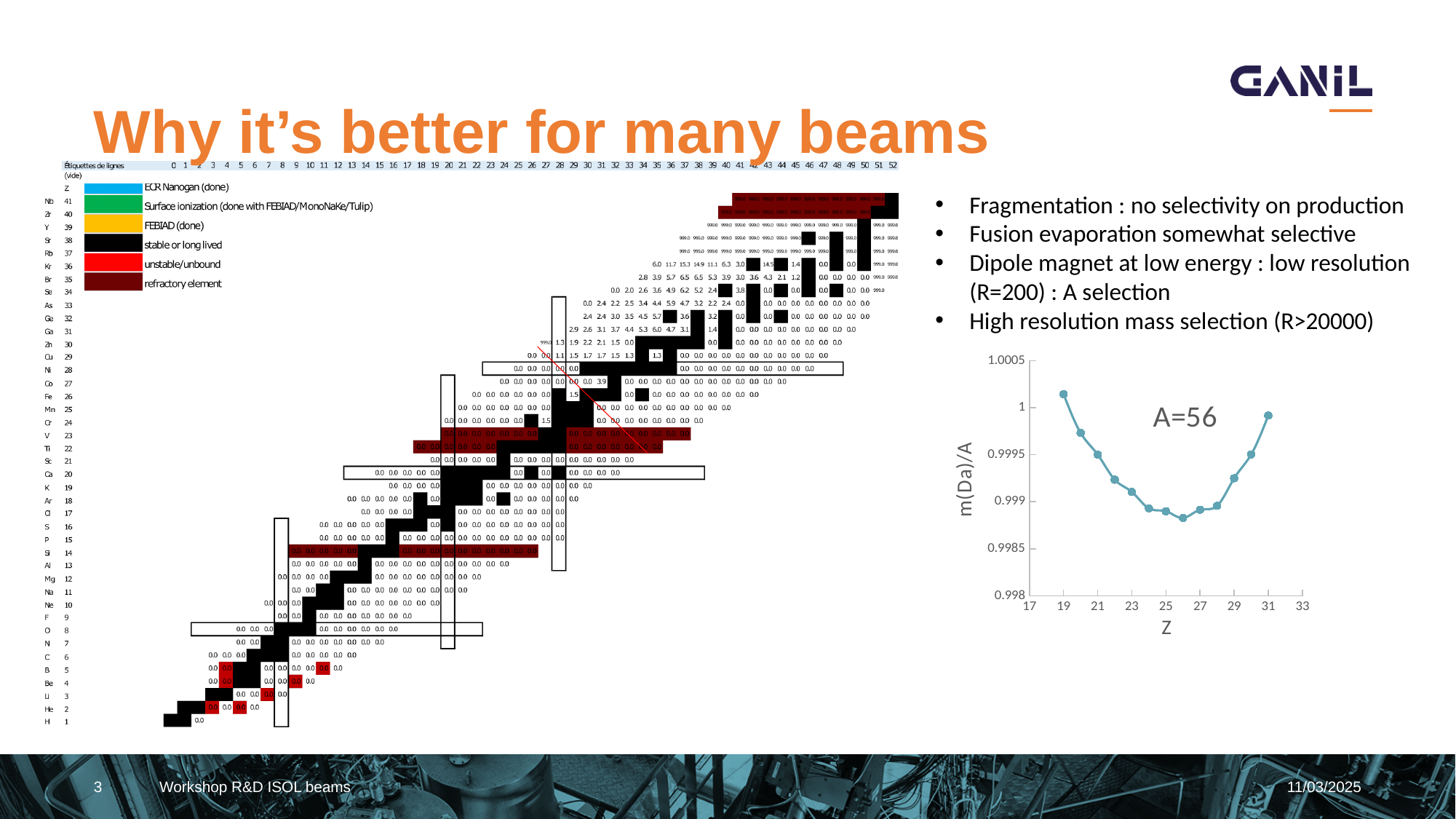
In the m(Da)/A versus Z chart, how many data points are plotted? 13 In the m(Da)/A versus Z chart, is the value at Z=26 greater or less than 0.999? less In the m(Da)/A versus Z chart, is the value at Z=31 greater or less than 1? less In the nuclide chart on the left, what colour does the legend use for 'stable or long lived'? black What kind of chart is the chart on the right of the slide, plotting m(Da)/A against Z? line chart In the m(Da)/A versus Z chart, what text label is shown inside the plot area? A=56 In the m(Da)/A versus Z chart, is the value at Z=19 greater or less than 1? greater In the m(Da)/A versus Z chart, which has the larger m(Da)/A: Z=19 or Z=31? Z=19 In the m(Da)/A versus Z chart, do the values rise or fall as Z increases from 19 to 25? fall In the m(Da)/A versus Z chart, which Z value has the highest m(Da)/A? 19 In the m(Da)/A versus Z chart, which has the larger m(Da)/A: Z=20 or Z=30? Z=20